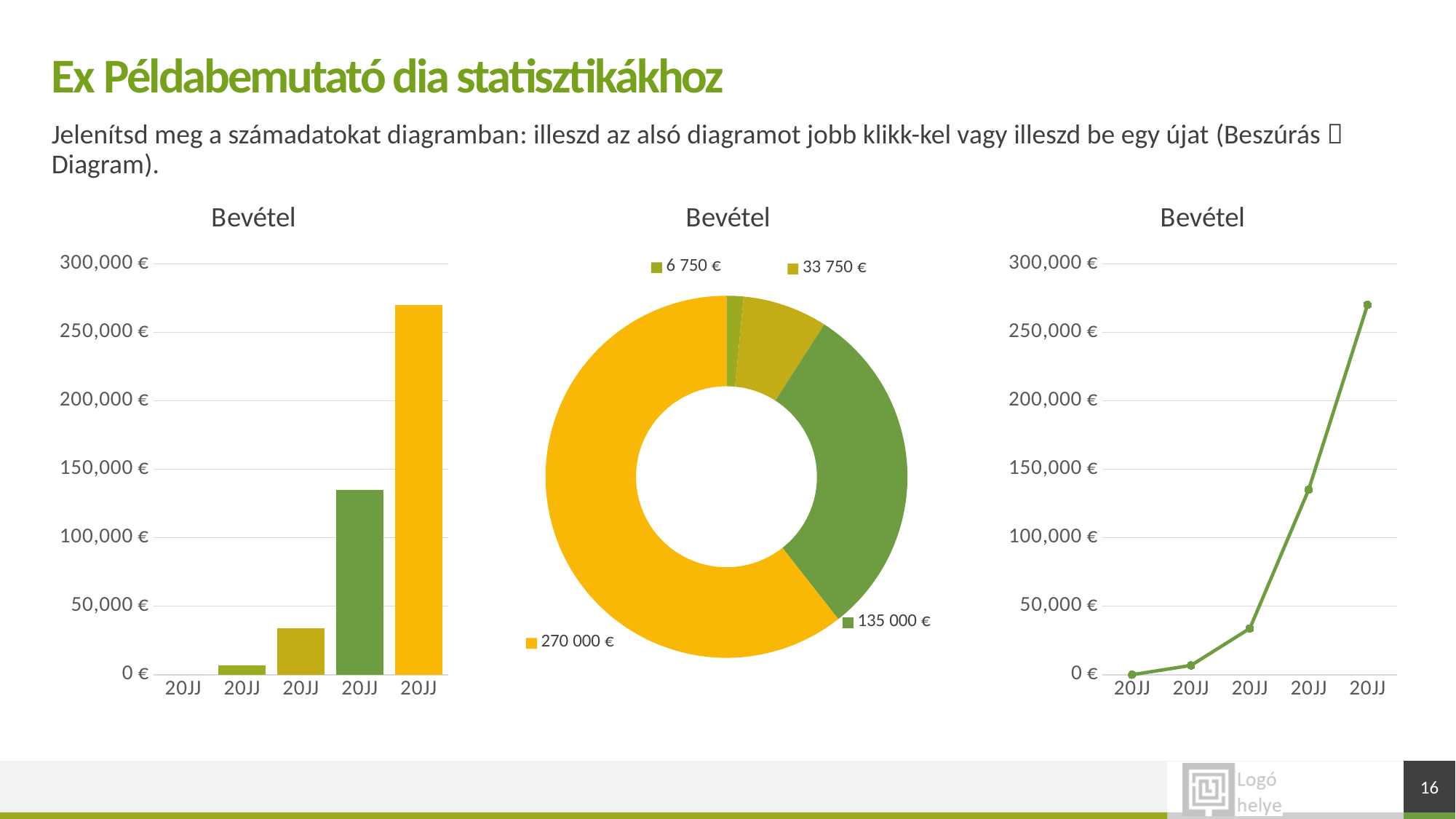
In the right-hand line chart, is the value of the last point greater or less than 250,000 €? greater In the left-hand bar chart, is the value of the fourth bar greater or less than 100,000 €? greater In the middle doughnut chart, what is the value of the largest slice? 270 000 € What type of chart is the middle chart titled Bevétel? doughnut (pie) chart In the middle doughnut chart, what is the value of the smallest labelled slice? 6 750 € What type of chart is the right-hand chart titled Bevétel? line chart In the left-hand bar chart, which bar is the tallest? the fifth (rightmost) bar In the left-hand bar chart, is the value of the third bar greater or less than 50,000 €? less In the left-hand bar chart, do the values rise or fall from left to right? rise What type of chart is the left-hand chart titled Bevétel? bar chart In the middle doughnut chart, what is the difference between the 270 000 € slice and the 135 000 € slice? 135 000 €